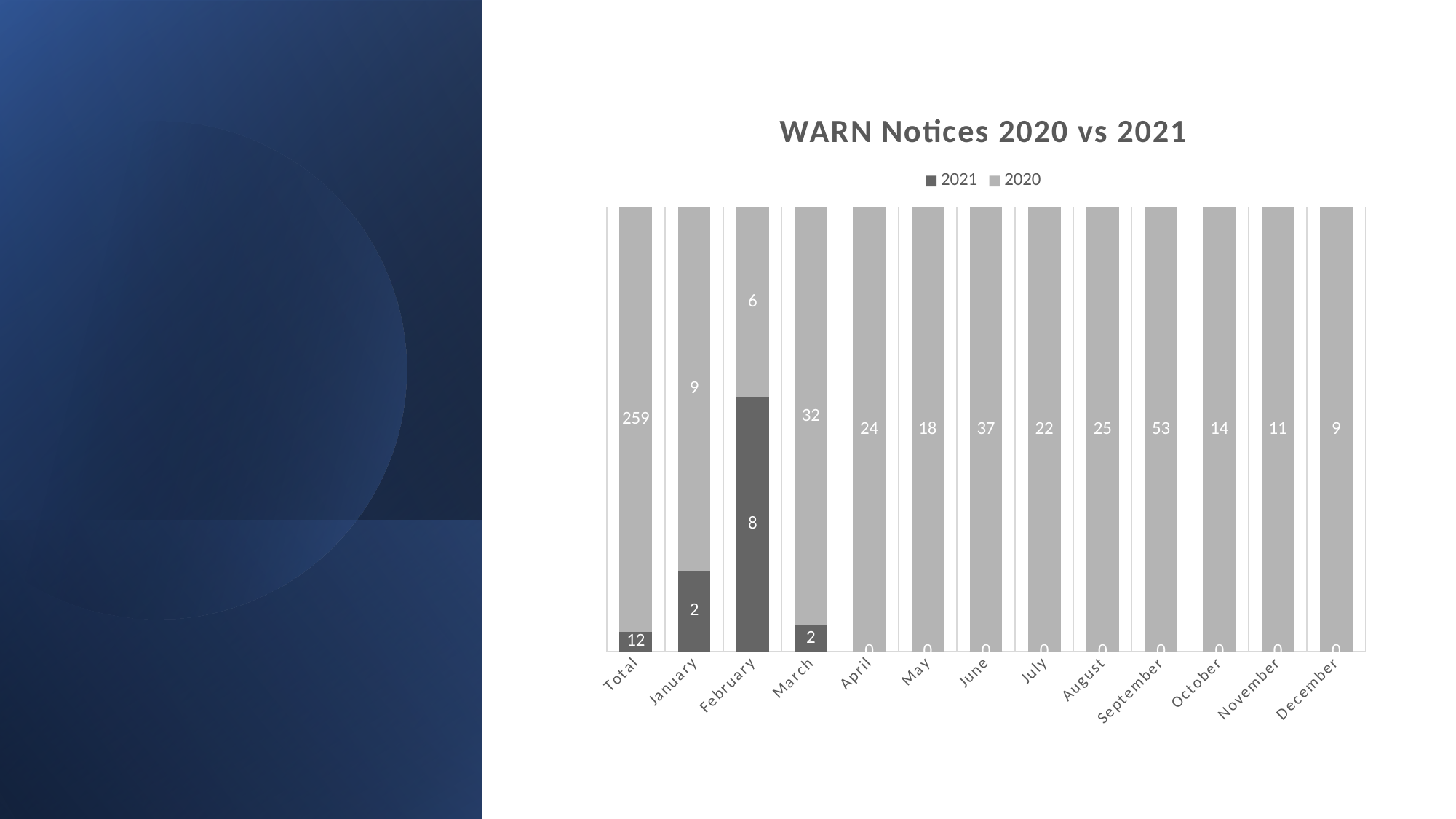
What is the 2020 value for the Total category? 259 What kind of chart is shown on the slide? Stacked bar chart What is the value for 2021 in February? 8 How many categories are shown on the x axis? 13 What is the value for 2020 in September? 53 Excluding the Total category, which month has the lowest 2020 value? February Excluding the Total category, which month has the highest 2020 value? September Which is larger, the 2020 value for March or the 2020 value for August? March How many series does the legend list? 2 What is the value for 2021 in April? 0 What is the combined total of the 2021 and 2020 values for February? 14 What is the difference between the 2020 values for June and May? 19